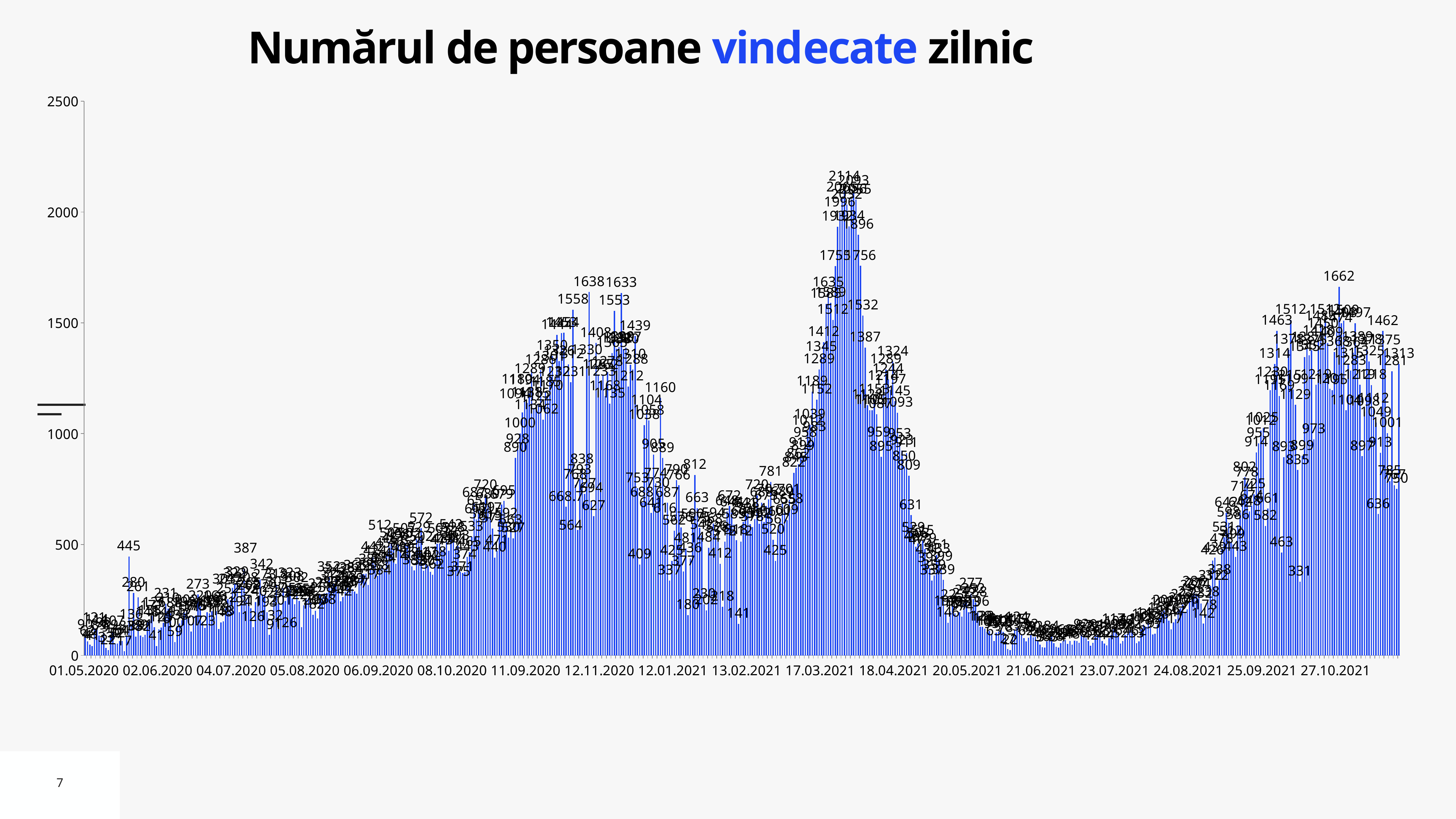
What is the first date label on the x axis? 01.05.2020 Is the peak value around 17.03.2021 greater or less than 2000? greater What is the highest labeled value in the wave after 25.09.2021? 1662 What is the highest data label shown on the chart? 2114 Do the values rise or fall between 18.04.2021 and 21.06.2021? fall What kind of chart is shown on the slide? bar chart Which peak is higher: the one around 12.11.2020 or the one around 17.03.2021? 17.03.2021 Do the values rise or fall between 24.08.2021 and 25.09.2021? rise Are the values around 21.06.2021 greater or less than 500? less What is the value of the isolated tall bar just before 02.06.2020? 445 What is the lowest data label shown on the chart, near 21.06.2021? 22 What is the title of the chart? Numărul de persoane vindecate zilnic